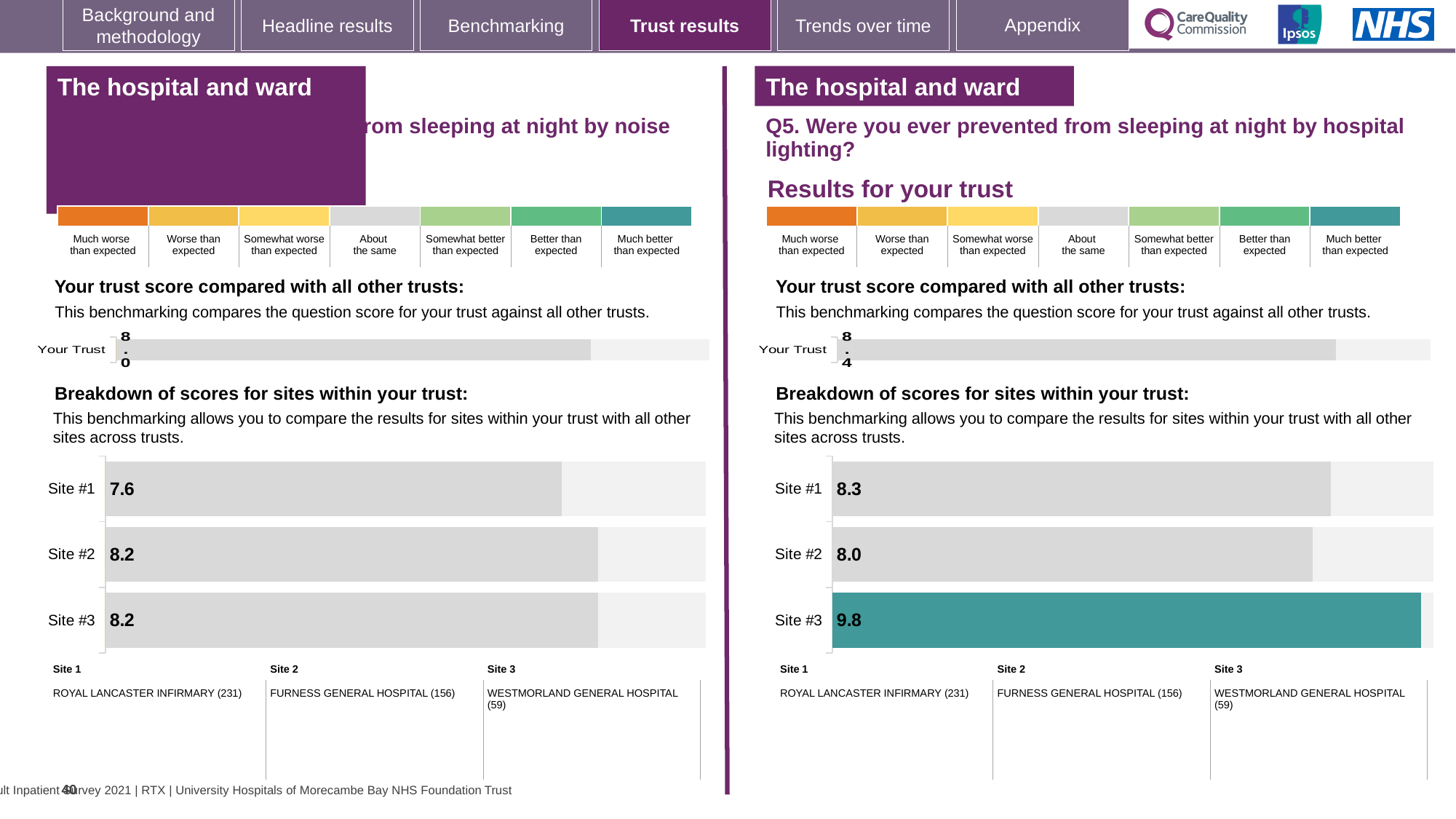
How many sites are shown in the right-hand 'Breakdown of scores for sites within your trust' chart? 3 On the right-hand chart (Q5, hospital lighting), what is the difference between the scores for Site #3 and Site #1? 1.5 On the left-hand chart (sleeping at night by noise), what is the score for Site #3? 8.2 On the right-hand 'Your trust score compared with all other trusts' chart, what is the score for Your Trust? 8.4 On the right-hand chart (Q5, hospital lighting), what is the score for Site #2? 8.0 On the left-hand 'Your trust score compared with all other trusts' chart, what is the score for Your Trust? 8.0 On the left-hand chart (sleeping at night by noise), what is the difference between the scores for Site #2 and Site #1? 0.6 On the right-hand chart (Q5, hospital lighting), which site has the highest score? Site #3 Which is larger: the Site #1 score on the left-hand chart or the Site #1 score on the right-hand chart (Q5)? Right-hand chart (Q5) On the right-hand chart (Q5, hospital lighting), what is the score for Site #3? 9.8 On the left-hand chart (sleeping at night by noise), what is the score for Site #1? 7.6 On the left-hand chart (sleeping at night by noise), which site has the lowest score? Site #1